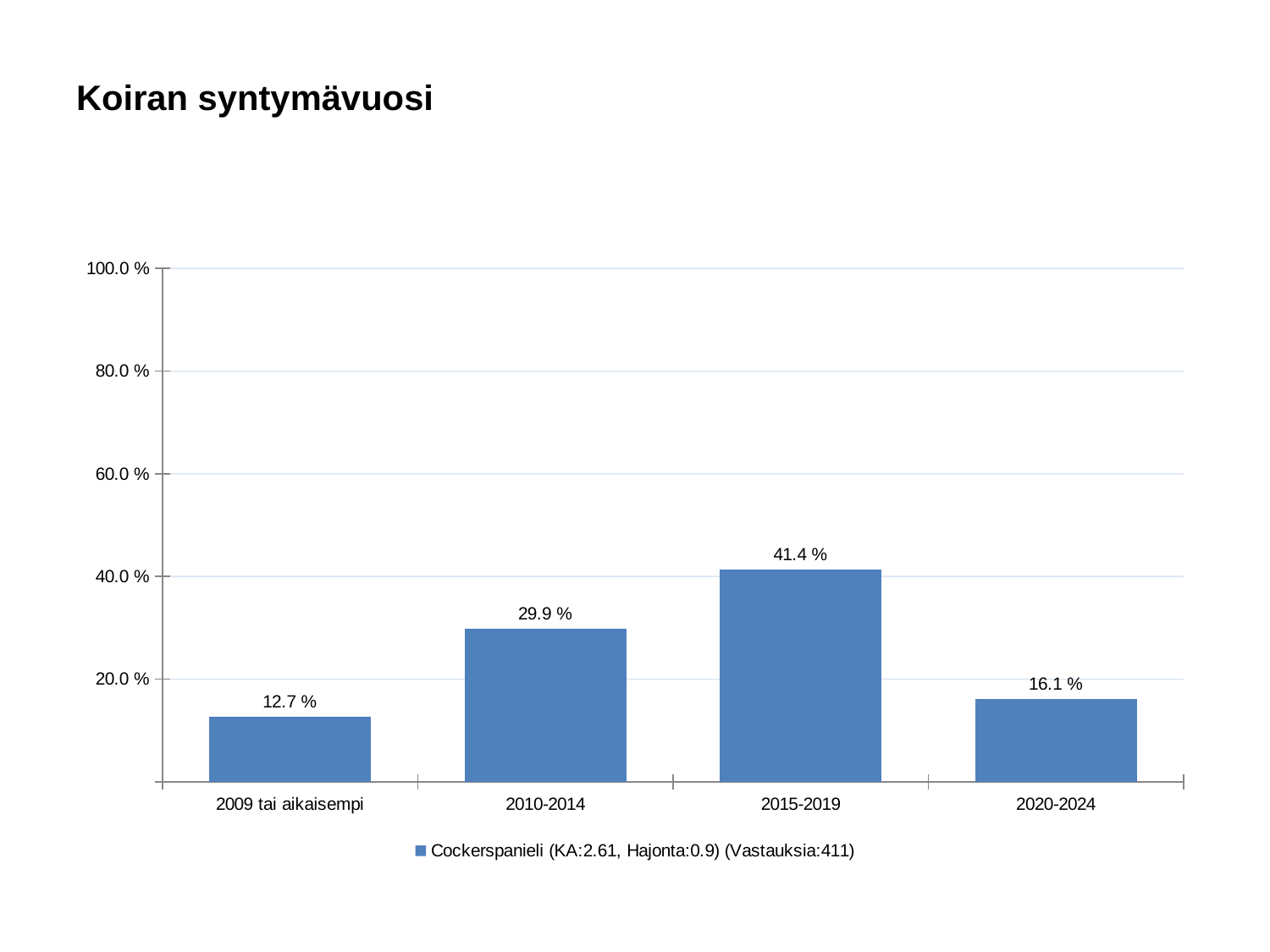
What kind of chart is shown on the slide? bar chart How many categories are shown on the x axis? 4 Which category has the highest value? 2015-2019 Is the value for 2010-2014 greater or less than 40.0 %? less What is the title of the slide? Koiran syntymävuosi What is the value for 2015-2019? 41.4 % Which is larger, the value for 2020-2024 or the value for 2009 tai aikaisempi? 2020-2024 What is the difference between the values for 2015-2019 and 2010-2014? 11.5 % Which category has the lowest value? 2009 tai aikaisempi How many series does the legend list? 1 What is the value for 2020-2024? 16.1 % What is the value for 2009 tai aikaisempi? 12.7 %